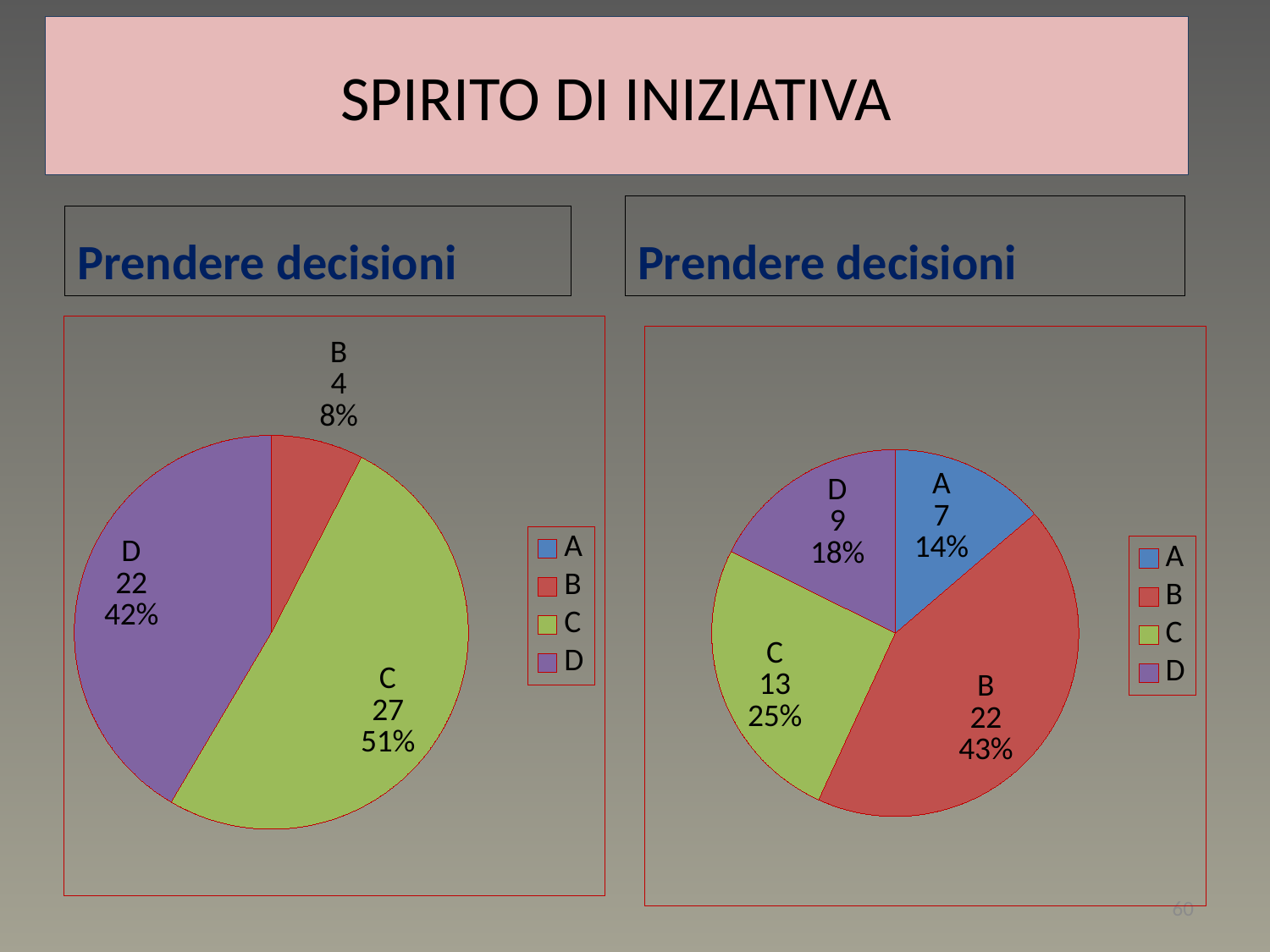
How many entries does the legend of the right pie chart list? 4 In the right pie chart, what is the difference between the values for B and C? 9 In the right pie chart, what share of the pie does category A have? 14% In the left pie chart, what is the value for category C? 27 What kind of chart is shown on the left side of the slide? Pie chart In the right pie chart, which category has the largest slice? B In the left pie chart, what is the difference between the values for C and D? 5 In the left pie chart, which category has the smallest slice? B In the right pie chart, what is the value for category B? 22 In the right pie chart, which is larger, the value for C or the value for D? C In the left pie chart, which category has the largest slice? C In the left pie chart, what share of the pie does category D have? 42%